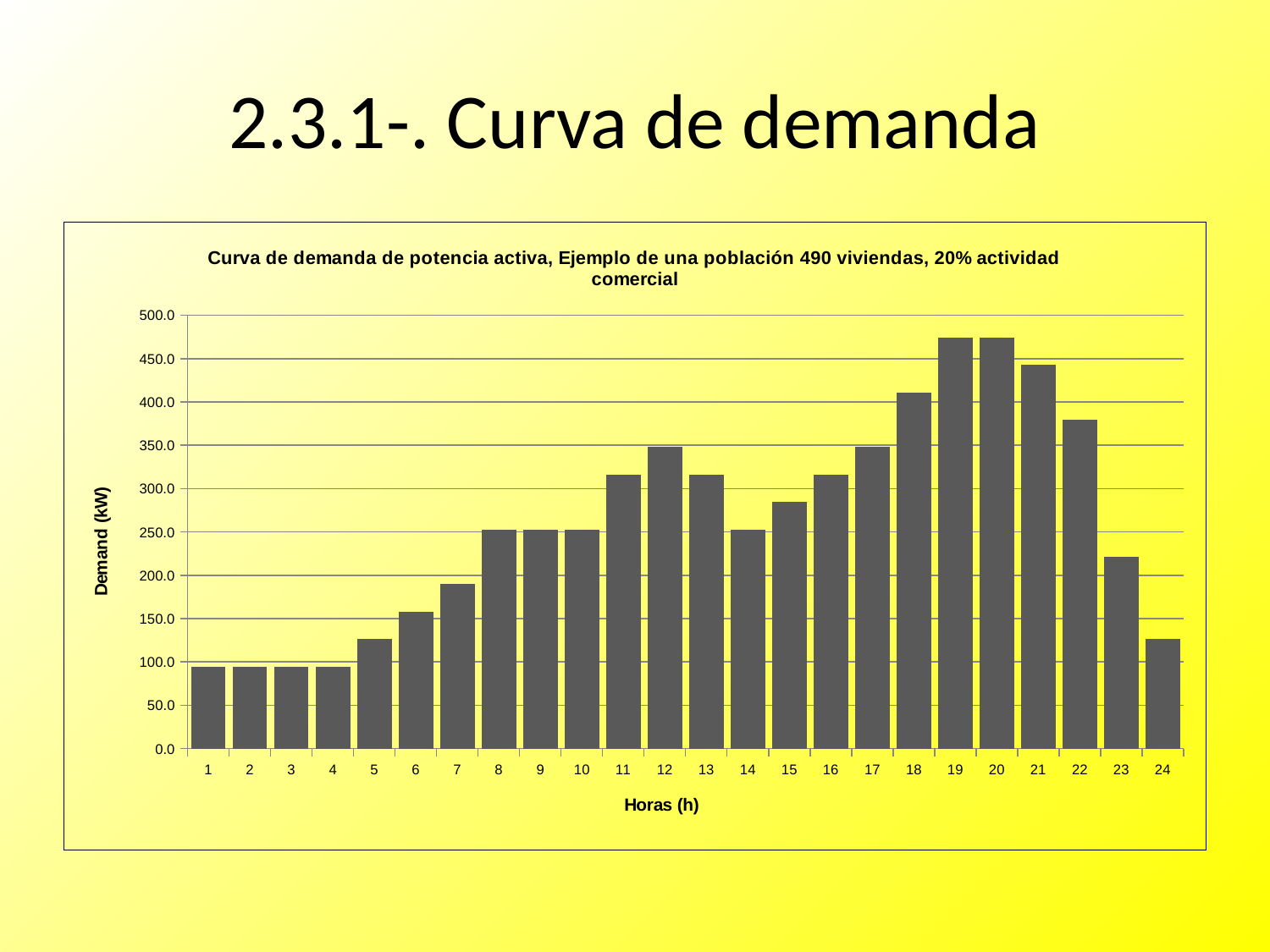
What is the label of the y axis? Demand (kW) Which hour has the higher demand, hour 12 or hour 14? hour 12 Is the demand value at hour 5 greater or less than 100? greater What is the label of the x axis? Horas (h) Which hour has the higher demand, hour 22 or hour 23? hour 22 What kind of chart is shown on the slide? bar chart How many hours (categories) are plotted on the x axis? 24 Is the demand value at hour 23 greater or less than 200? greater Is the demand value at hour 12 greater or less than 300? greater Does the demand rise or fall from hour 20 to hour 24? fall